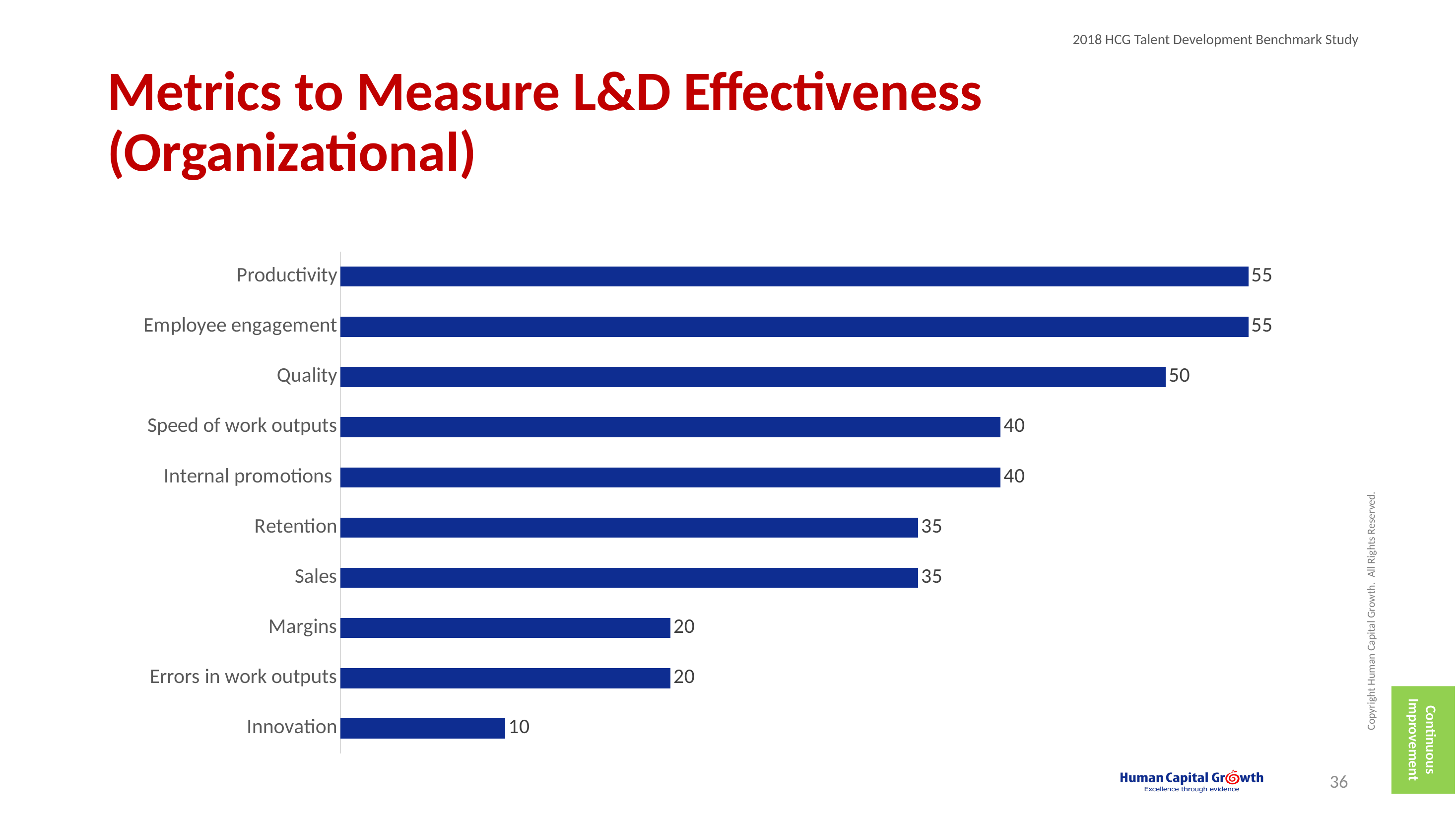
What is the difference between the values for Productivity and Innovation? 45 How many categories are shown in the chart? 10 What is the value for Quality? 50 Which is larger, the value for Employee engagement or the value for Internal promotions? Employee engagement Which is larger, the value for Speed of work outputs or the value for Errors in work outputs? Speed of work outputs What is the value for Margins? 20 What colour are the bars in the chart? Blue What is the difference between the values for Quality and Sales? 15 Which category has the lowest value? Innovation What kind of chart is shown on the slide? Bar chart What is the value for Innovation? 10 What is the value for Retention? 35